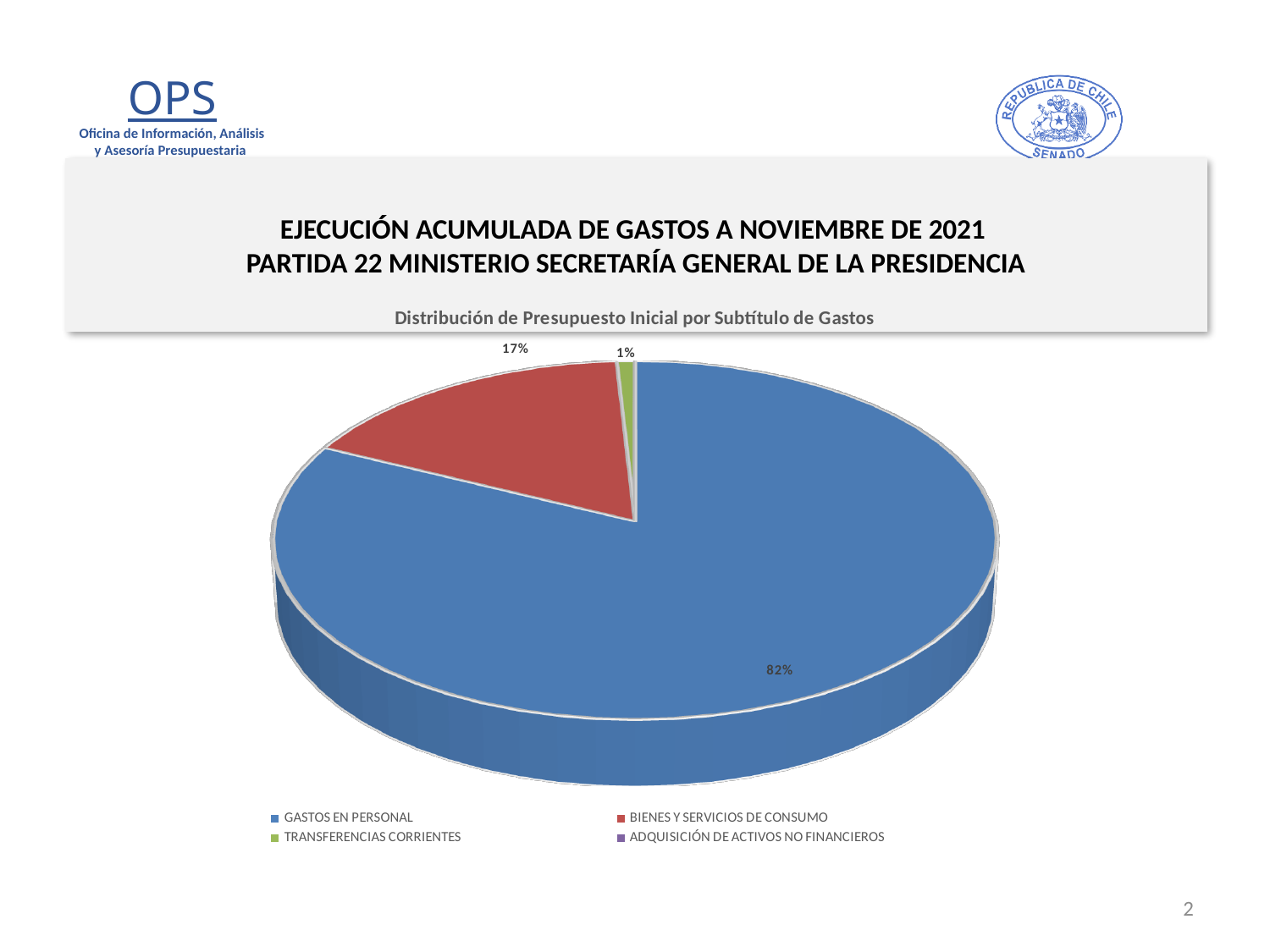
What is the title of the chart? Distribución de Presupuesto Inicial por Subtítulo de Gastos What kind of chart is shown on the slide? pie chart How many categories does the legend list? 4 What share of the pie does TRANSFERENCIAS CORRIENTES represent? 1% What colour is the slice for GASTOS EN PERSONAL? blue What is the difference in percentage points between the GASTOS EN PERSONAL slice and the BIENES Y SERVICIOS DE CONSUMO slice? 65 percentage points What share of the pie does BIENES Y SERVICIOS DE CONSUMO represent? 17% What share of the pie does GASTOS EN PERSONAL represent? 82% Which is larger, the slice for BIENES Y SERVICIOS DE CONSUMO or the slice for TRANSFERENCIAS CORRIENTES? BIENES Y SERVICIOS DE CONSUMO Which category has the largest slice of the pie? GASTOS EN PERSONAL Is the share for GASTOS EN PERSONAL greater or less than 50%? greater